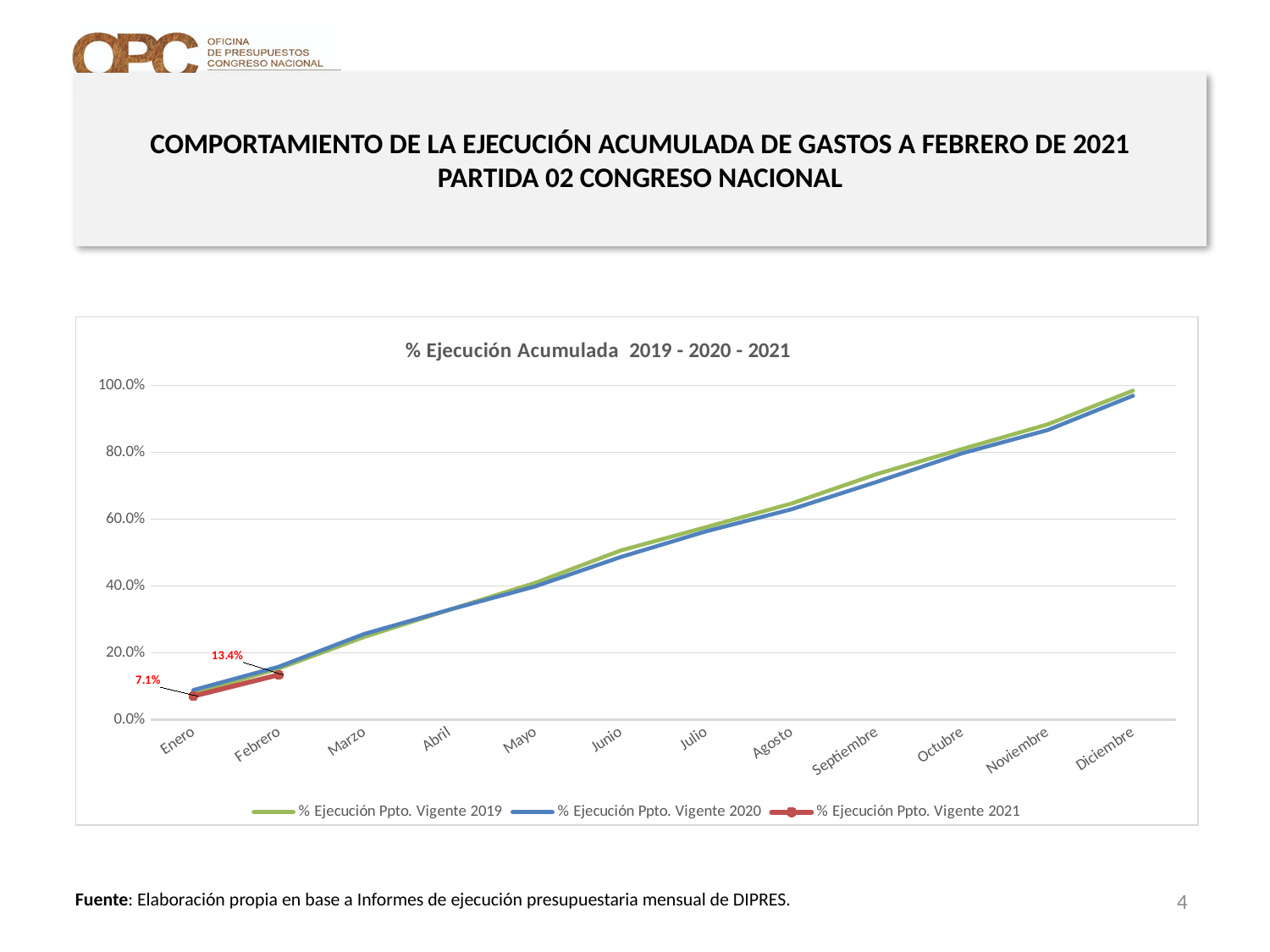
In the % Ejecución Ppto. Vigente 2021 series, which month has the larger value, Enero or Febrero? Febrero What is the value for Febrero in the % Ejecución Ppto. Vigente 2021 series? 13.4% How many months are shown on the x axis of the chart? 12 Is the value for Marzo in the % Ejecución Ppto. Vigente 2019 series greater or less than 40.0%? less Do the values of the % Ejecución Ppto. Vigente 2020 series rise or fall from Enero to Diciembre? Rise What is the value for Enero in the % Ejecución Ppto. Vigente 2021 series? 7.1% What kind of chart is shown on the slide? Line chart Is the value for Diciembre in the % Ejecución Ppto. Vigente 2020 series greater or less than 80.0%? greater How many series does the chart legend list? 3 What is the difference between the Febrero and Enero values of the % Ejecución Ppto. Vigente 2021 series? 6.3% What is the title of the chart? % Ejecución Acumulada 2019 - 2020 - 2021 Is the value for Octubre in the % Ejecución Ppto. Vigente 2019 series greater or less than 60.0%? greater